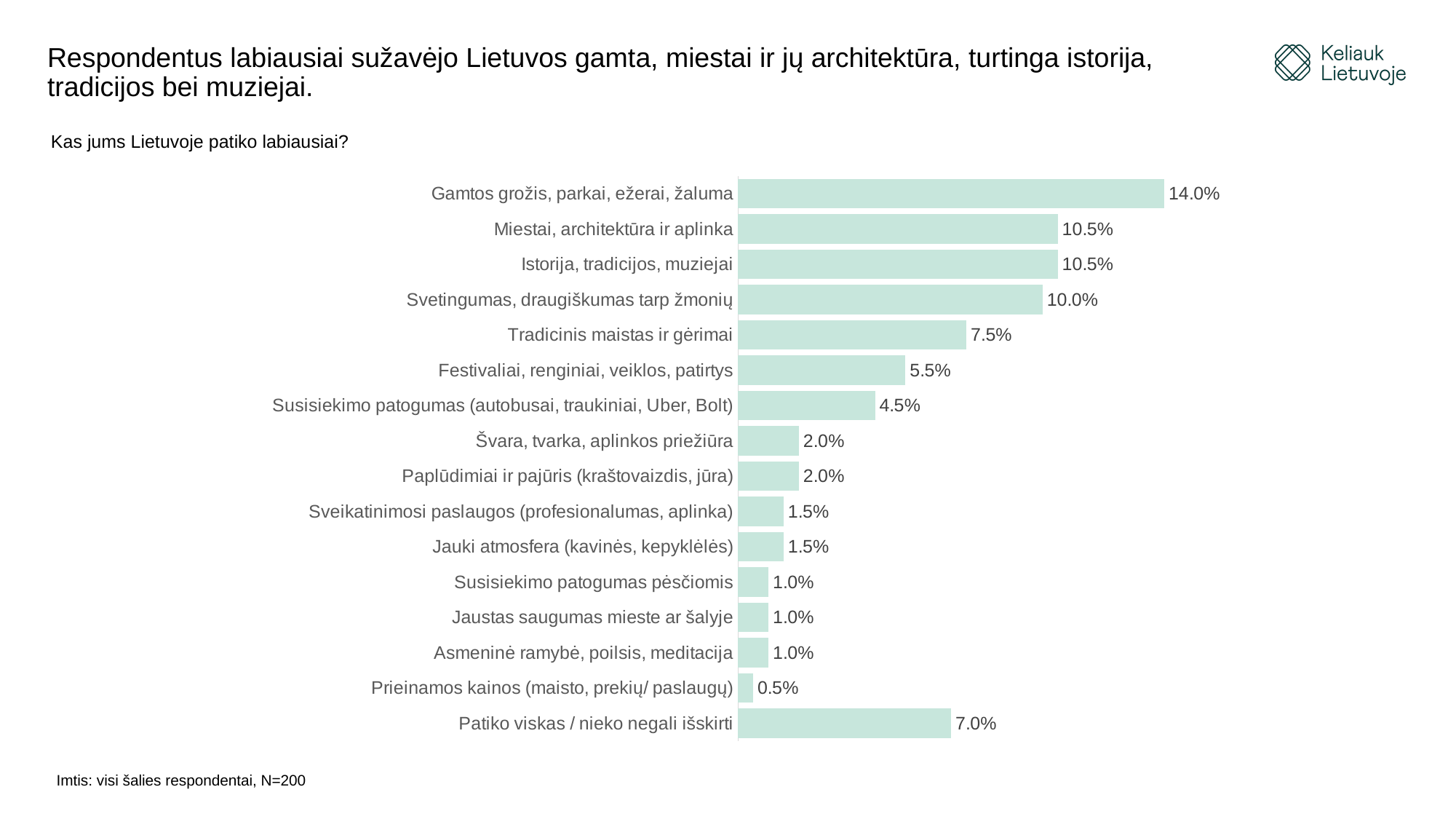
What kind of chart is shown on the slide? Bar chart Which is larger: the value for "Svetingumas, draugiškumas tarp žmonių" or the value for "Tradicinis maistas ir gėrimai"? Svetingumas, draugiškumas tarp žmonių What is the value for "Gamtos grožis, parkai, ežerai, žaluma"? 14.0% Which category has the lowest value? Prieinamos kainos (maisto, prekių/ paslaugų) Which category has the highest value? Gamtos grožis, parkai, ežerai, žaluma What is the value for "Tradicinis maistas ir gėrimai"? 7.5% What is the value for "Susisiekimo patogumas (autobusai, traukiniai, Uber, Bolt)"? 4.5% What is the value for "Patiko viskas / nieko negali išskirti"? 7.0% What question is the chart based on, as written above the chart? Kas jums Lietuvoje patiko labiausiai? What is the difference between the values for "Festivaliai, renginiai, veiklos, patirtys" and "Švara, tvarka, aplinkos priežiūra"? 3.5% How many categories are shown in the chart? 16 What is the difference between the values for "Gamtos grožis, parkai, ežerai, žaluma" and "Miestai, architektūra ir aplinka"? 3.5%